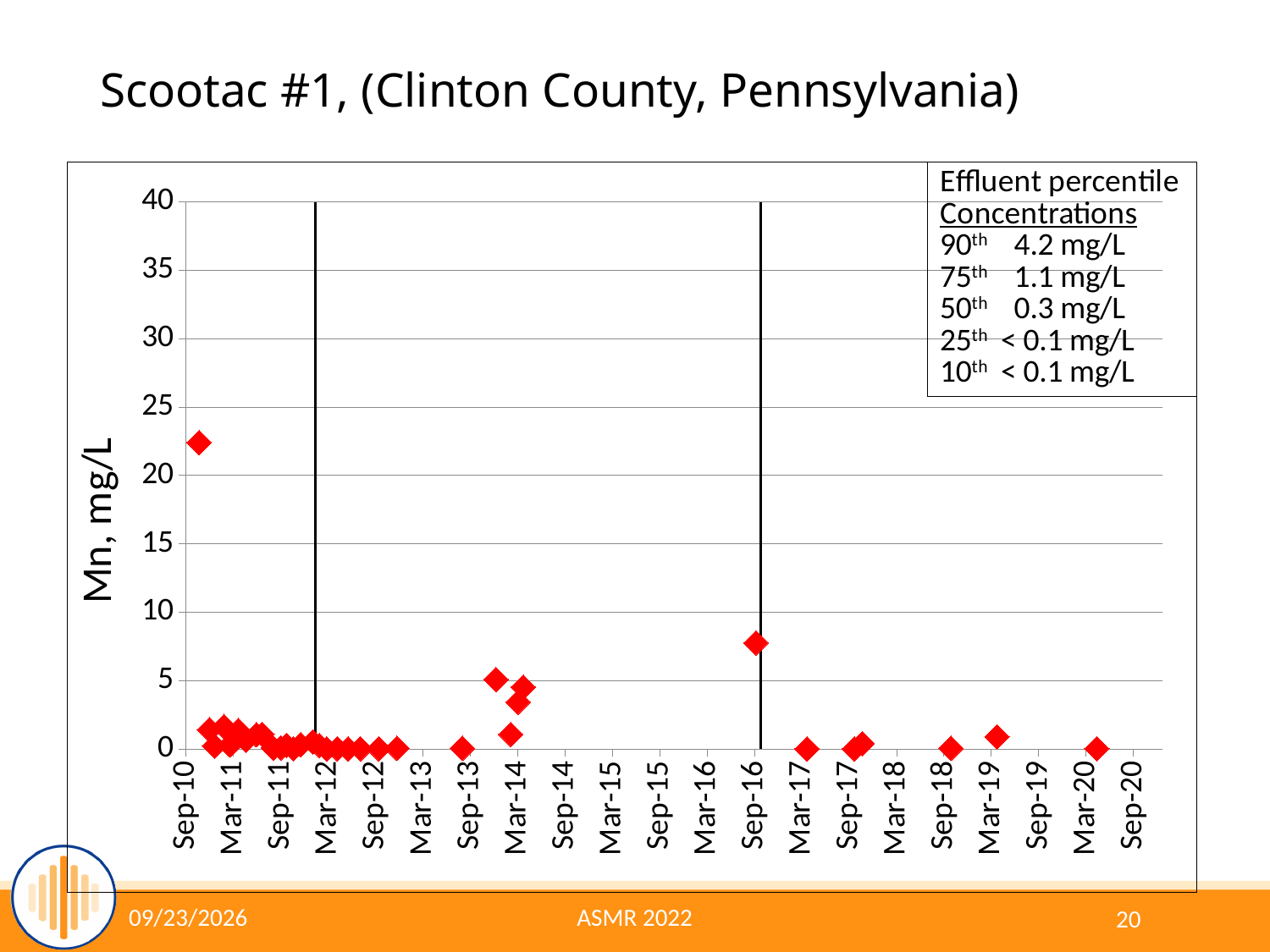
Is the Mn value of the point near Mar-17 greater or less than 5? less What is the label on the y-axis of the chart? Mn, mg/L What kind of chart is shown on the slide? scatter chart Is the Mn value of the point near Sep-16 greater or less than 10? less What is the title shown above the chart? Scootac #1, (Clinton County, Pennsylvania) Is the highest Mn value plotted near Mar-14 greater or less than 10? less Near which x-axis date is the highest Mn value plotted? Sep-10 Which has the larger Mn value: the point near Sep-10 or the point near Sep-16? Sep-10 According to the effluent percentile box on the chart, what is the 90th percentile Mn concentration? 4.2 mg/L Do the Mn values generally rise or fall from Sep-10 to Sep-20? fall